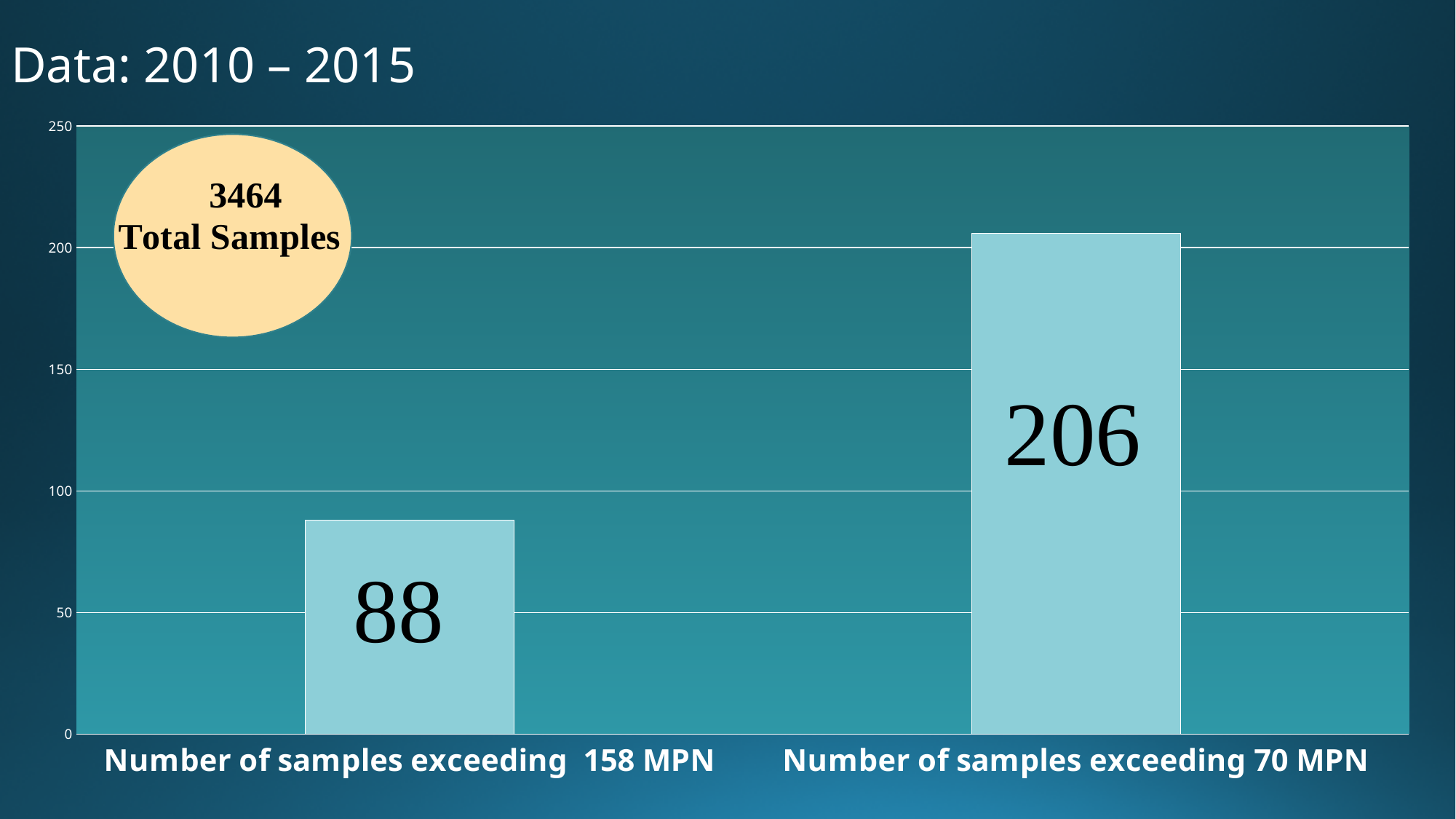
Is the value for samples exceeding 158 MPN larger or smaller than the value for samples exceeding 70 MPN? smaller What is the difference between the number of samples exceeding 70 MPN and the number exceeding 158 MPN? 118 What is the number of samples exceeding 70 MPN? 206 Is the value for samples exceeding 70 MPN greater or less than 200? greater Which category has the lower value? Number of samples exceeding 158 MPN What is the maximum value shown on the vertical axis? 250 What is the number of samples exceeding 158 MPN? 88 Is the value for samples exceeding 158 MPN greater or less than 100? less Which category has the higher value? Number of samples exceeding 70 MPN What is the total number of samples stated in the circle on the chart? 3464 What kind of chart is shown on the slide? bar chart How many categories are shown on the chart? 2